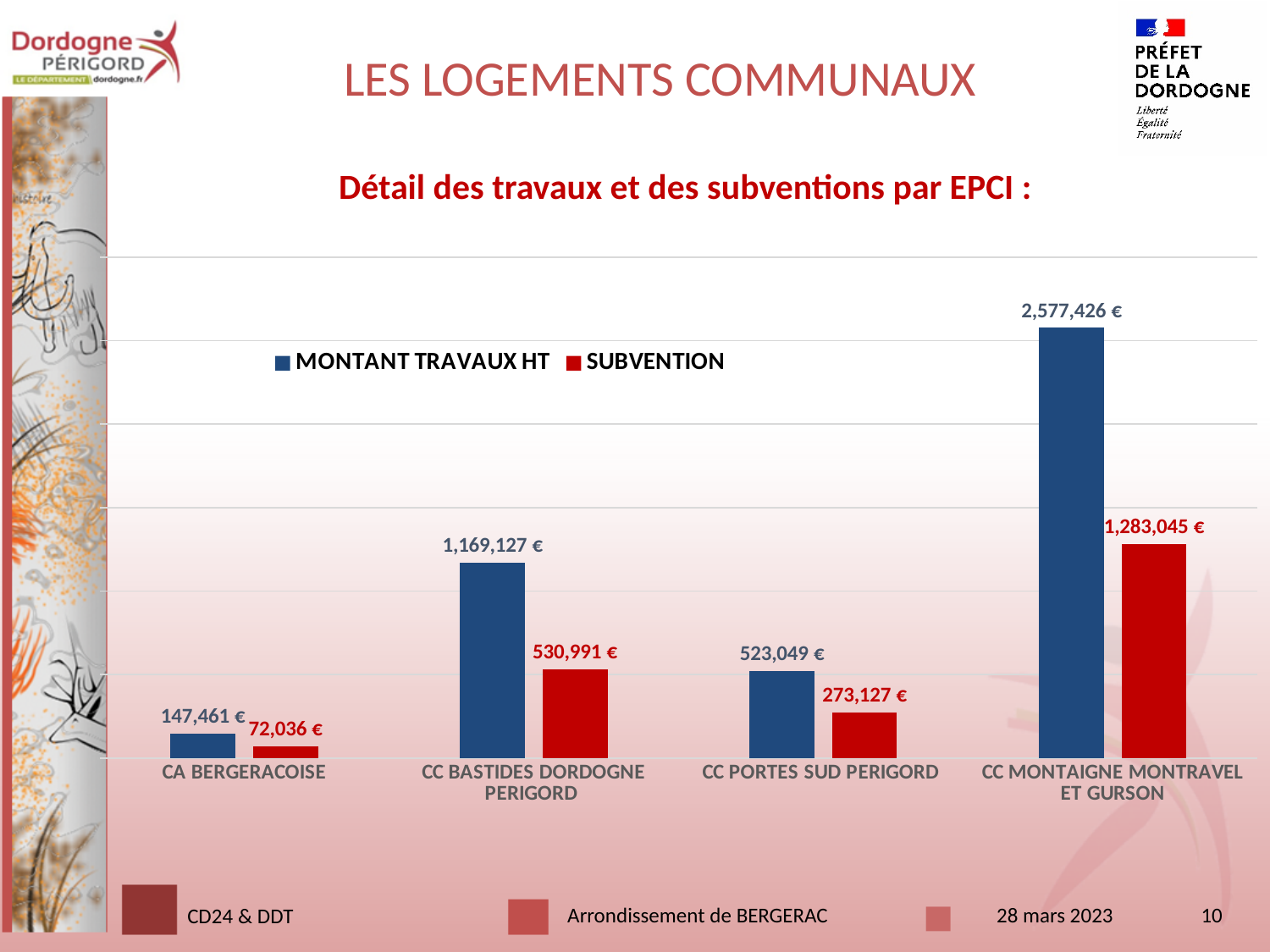
What is the MONTANT TRAVAUX HT value for CC PORTES SUD PERIGORD? 523,049 € What is the difference between MONTANT TRAVAUX HT and SUBVENTION for CC MONTAIGNE MONTRAVEL ET GURSON? 1,294,381 € What is the SUBVENTION value for CC BASTIDES DORDOGNE PERIGORD? 530,991 € How many series does the legend list? 2 What is the difference between MONTANT TRAVAUX HT and SUBVENTION for CC PORTES SUD PERIGORD? 249,922 € How many EPCI categories are shown on the chart? 4 Which is larger: the MONTANT TRAVAUX HT for CC BASTIDES DORDOGNE PERIGORD or for CC PORTES SUD PERIGORD? CC BASTIDES DORDOGNE PERIGORD What kind of chart is shown on the slide? Bar chart Which EPCI has the lowest SUBVENTION? CA BERGERACOISE Which EPCI has the highest MONTANT TRAVAUX HT? CC MONTAIGNE MONTRAVEL ET GURSON What is the SUBVENTION value for CA BERGERACOISE? 72,036 € What is the MONTANT TRAVAUX HT value for CC MONTAIGNE MONTRAVEL ET GURSON? 2,577,426 €